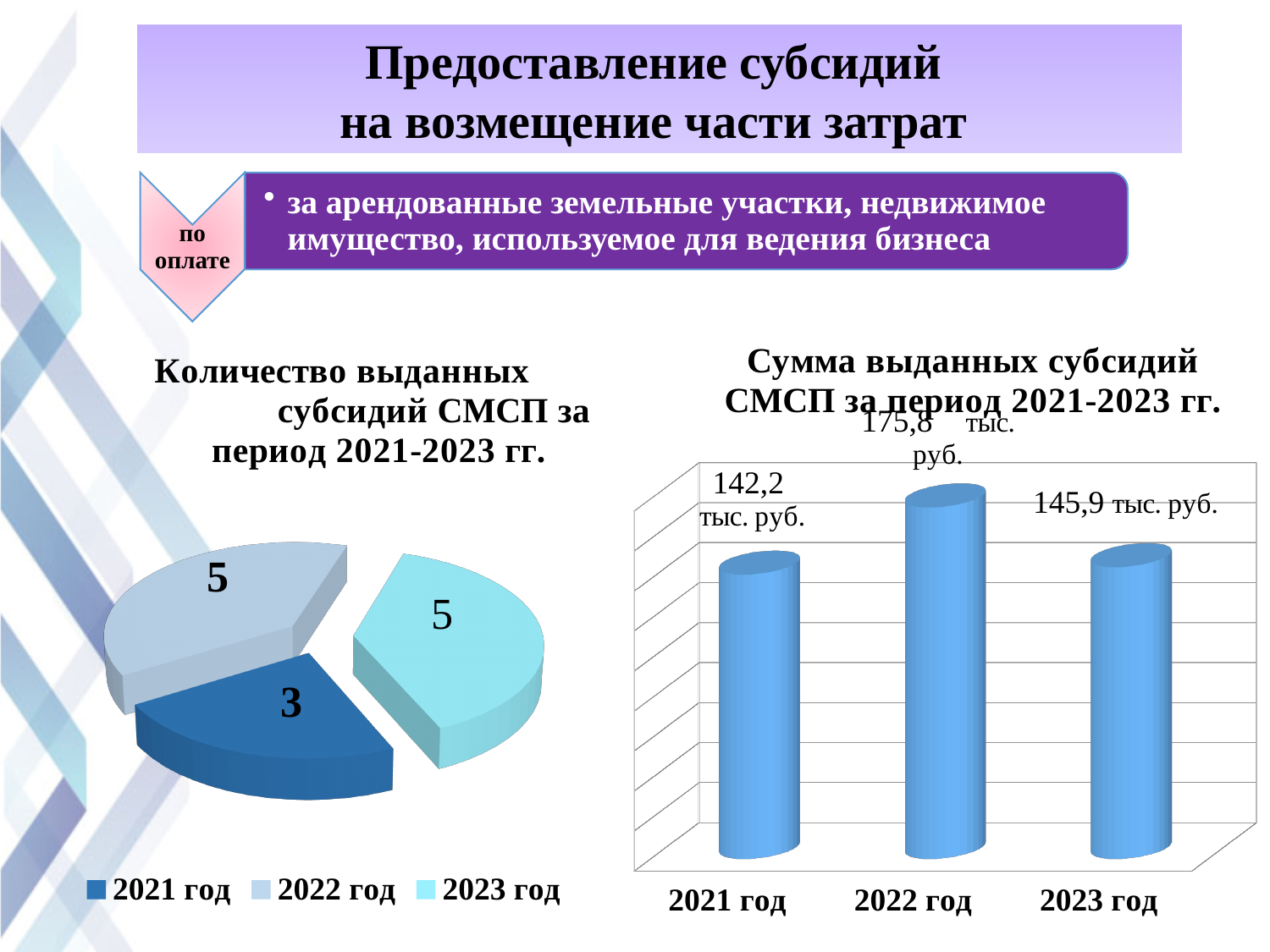
In the pie chart on the left, how many subsidies were issued in 2022? 5 In the bar chart on the right, which year has the highest amount of subsidies issued? 2022 год In the bar chart on the right, what is the amount of subsidies issued in 2023? 145,9 тыс. руб. What type of chart is the chart on the left of the slide? Pie chart In the bar chart on the right, which is larger: the amount for 2023 or the amount for 2021? 2023 год In the pie chart on the left, what is the total number of subsidies issued over 2021-2023? 13 In the bar chart on the right, what is the amount of subsidies issued in 2022? 175,8 тыс. руб. In the pie chart on the left, how many categories does the legend list? 3 In the pie chart on the left, how many subsidies were issued in 2021? 3 In the bar chart on the right, what is the amount of subsidies issued in 2021? 142,2 тыс. руб. In the bar chart on the right, what is the difference between the amounts for 2022 and 2021? 33,6 тыс. руб. In the pie chart on the left, which year has the smallest number of issued subsidies? 2021 год